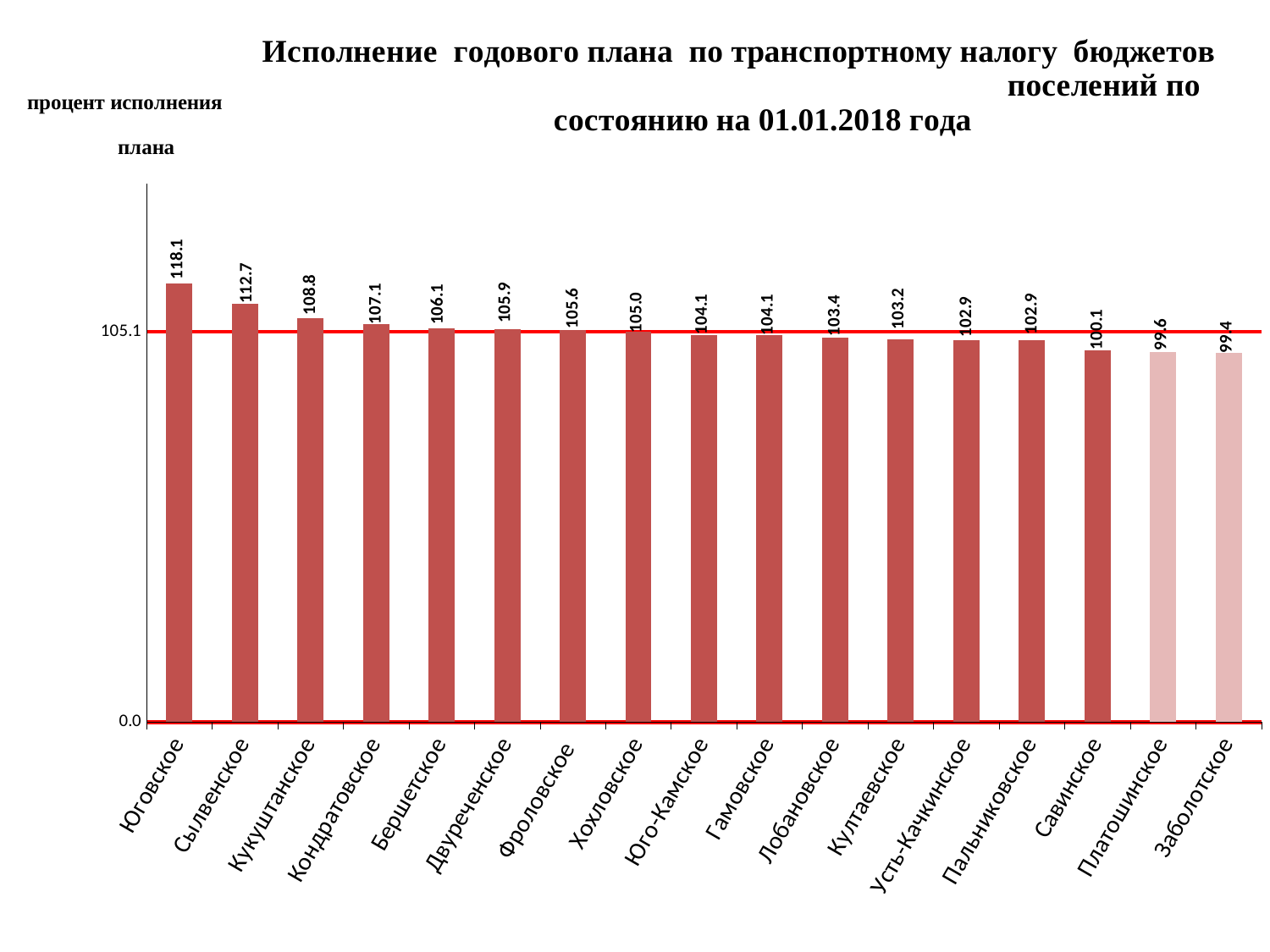
What is the value for Юговское? 118.1 Which category has the lowest value? Заболотское What value is marked by the horizontal red line across the chart? 105.1 What is the value for Кондратовское? 107.1 How many categories are shown on the x axis? 17 What kind of chart is shown on the slide? Bar chart Which is larger, the value for Бершетское or the value for Лобановское? Бершетское Do the values rise or fall from left to right along the x axis? Fall What is the value for Савинское? 100.1 What is the difference between the values for Кукуштанское and Заболотское? 9.4 Which category has the highest value? Юговское What is the difference between the values for Юговское and Сылвенское? 5.4